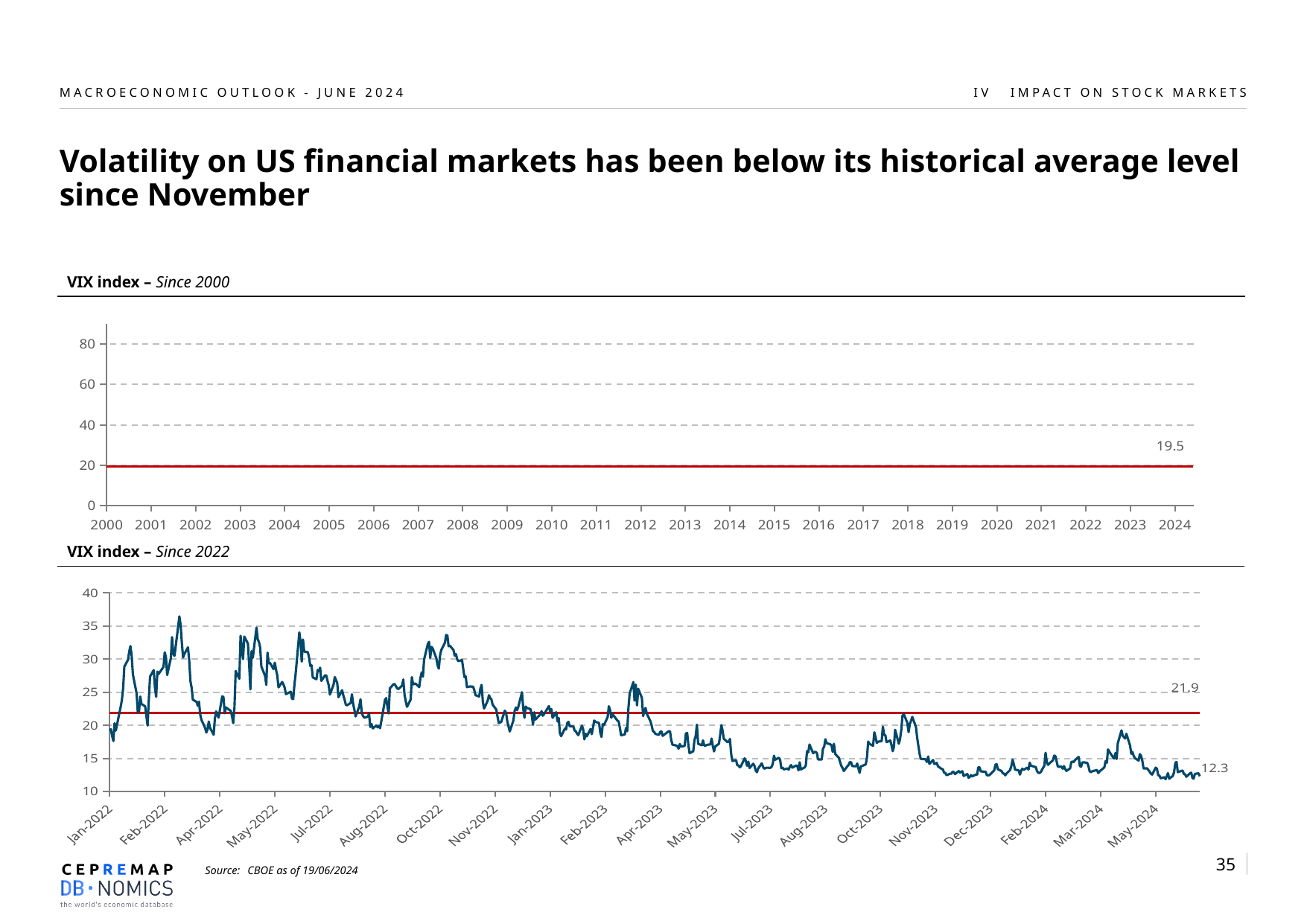
On the 'VIX index – Since 2022' chart, which is larger: the value around May-2022 or the value around May-2024? May-2022 On the 'VIX index – Since 2022' chart, does the VIX index generally rise or fall from early 2022 to mid 2024? Fall On the 'VIX index – Since 2022' chart, what is the last value labelled at the end of the line? 12.3 What kind of chart is the 'VIX index – Since 2022' chart? Line chart What is the highest value shown on the y axis of the 'VIX index – Since 2000' chart? 80 On the 'VIX index – Since 2022' chart, is the final labelled value (12.3) greater or less than the red line value (21.9)? less On the 'VIX index – Since 2022' chart, what value is labelled on the red horizontal line? 21.9 On the 'VIX index – Since 2000' chart, what value is labelled on the red horizontal line? 19.5 On the 'VIX index – Since 2022' chart, what is the difference between the red line value (21.9) and the final labelled value (12.3)? 9.6 On the 'VIX index – Since 2022' chart, is the peak value around Feb-2022 greater or less than 30? greater On the 'VIX index – Since 2022' chart, is the value around Jul-2023 greater or less than 20? less How many year labels are shown on the x axis of the 'VIX index – Since 2000' chart? 25